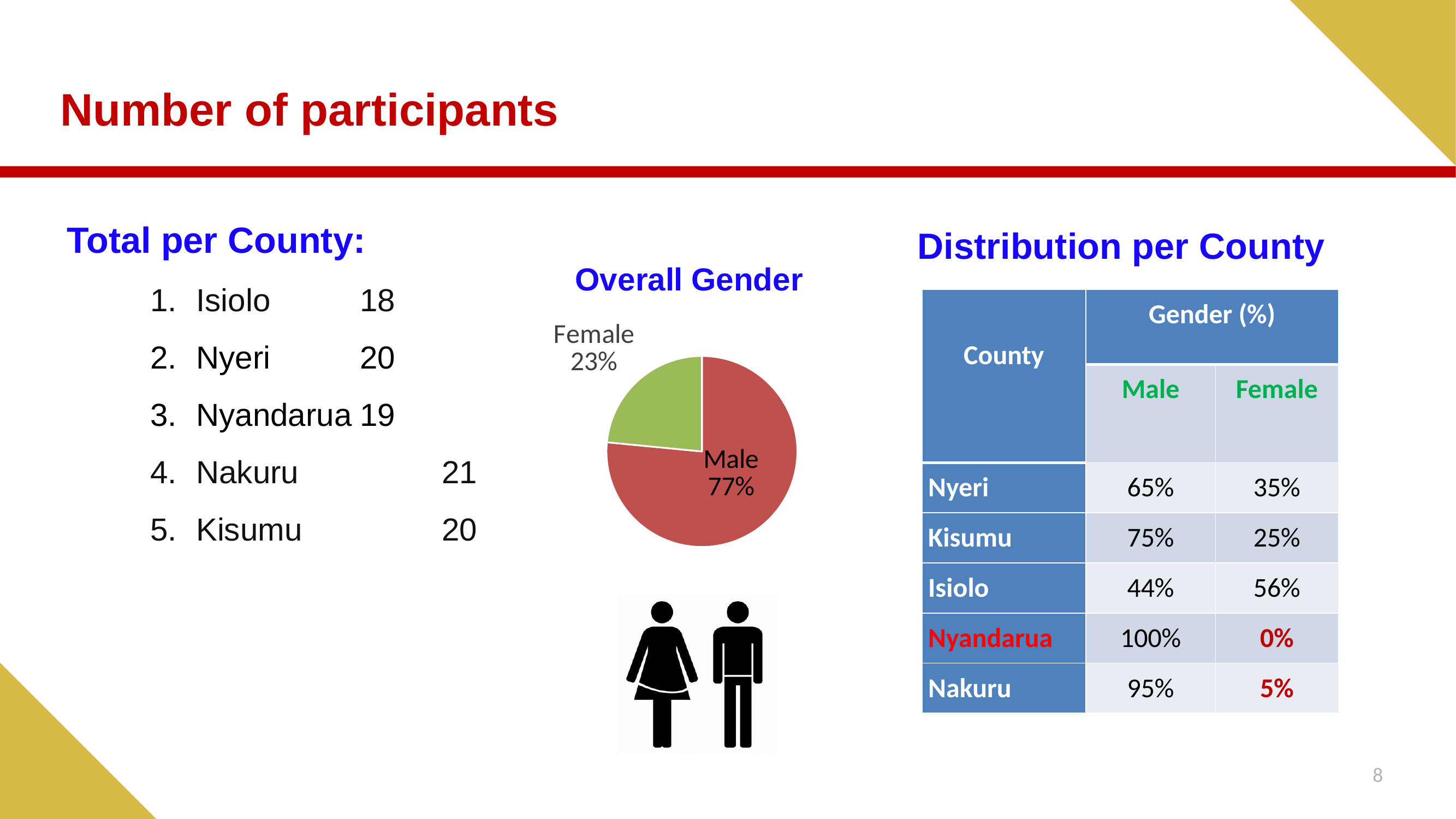
How many slices does the Overall Gender pie chart have? 2 What colour is the Female slice in the Overall Gender pie chart? green Which slice of the Overall Gender pie chart is the smallest? Female In the Overall Gender pie chart, which is larger, the Male slice or the Female slice? Male What share of the Overall Gender pie is Male? 77% What kind of chart is the Overall Gender chart? pie chart In the Overall Gender pie chart, what is the difference in percentage points between the Male and Female slices? 54 Which slice of the Overall Gender pie chart is the largest? Male What share of the Overall Gender pie is Female? 23% What is the title of the pie chart on the slide? Overall Gender